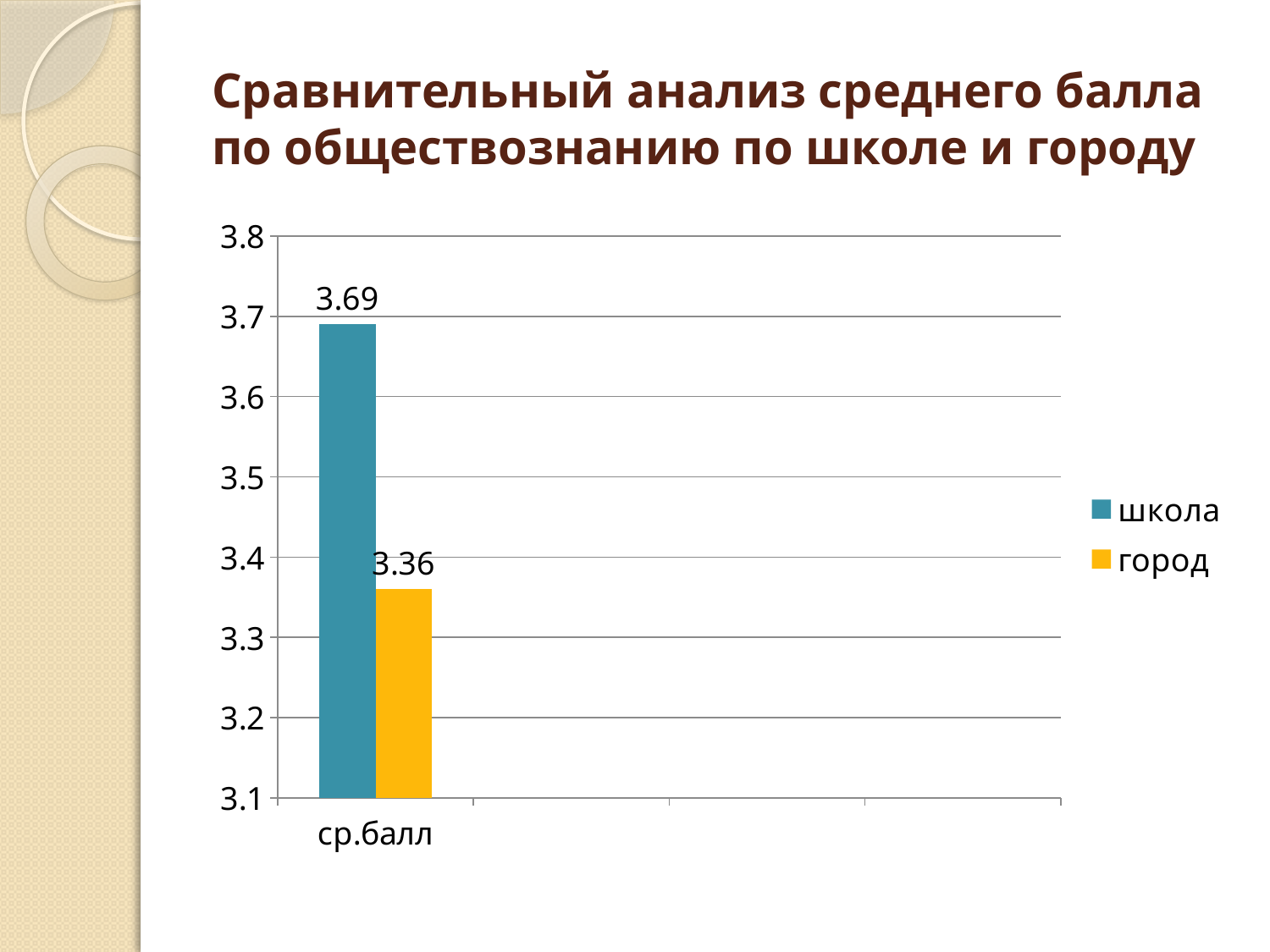
How many series does the legend list? 2 What is the value for школа in the ср.балл category? 3.69 What is the difference between the школа value and the город value? 0.33 What is the value for город in the ср.балл category? 3.36 Which series has the higher value, школа or город? школа What kind of chart is shown on the slide? bar chart What is the label of the category on the x axis? ср.балл Is the value for город greater or less than 3.4? less Is the value for школа greater or less than 3.6? greater What colour are the bars for the город series? yellow Which series has the lowest value? город How many categories are shown on the x axis? 1